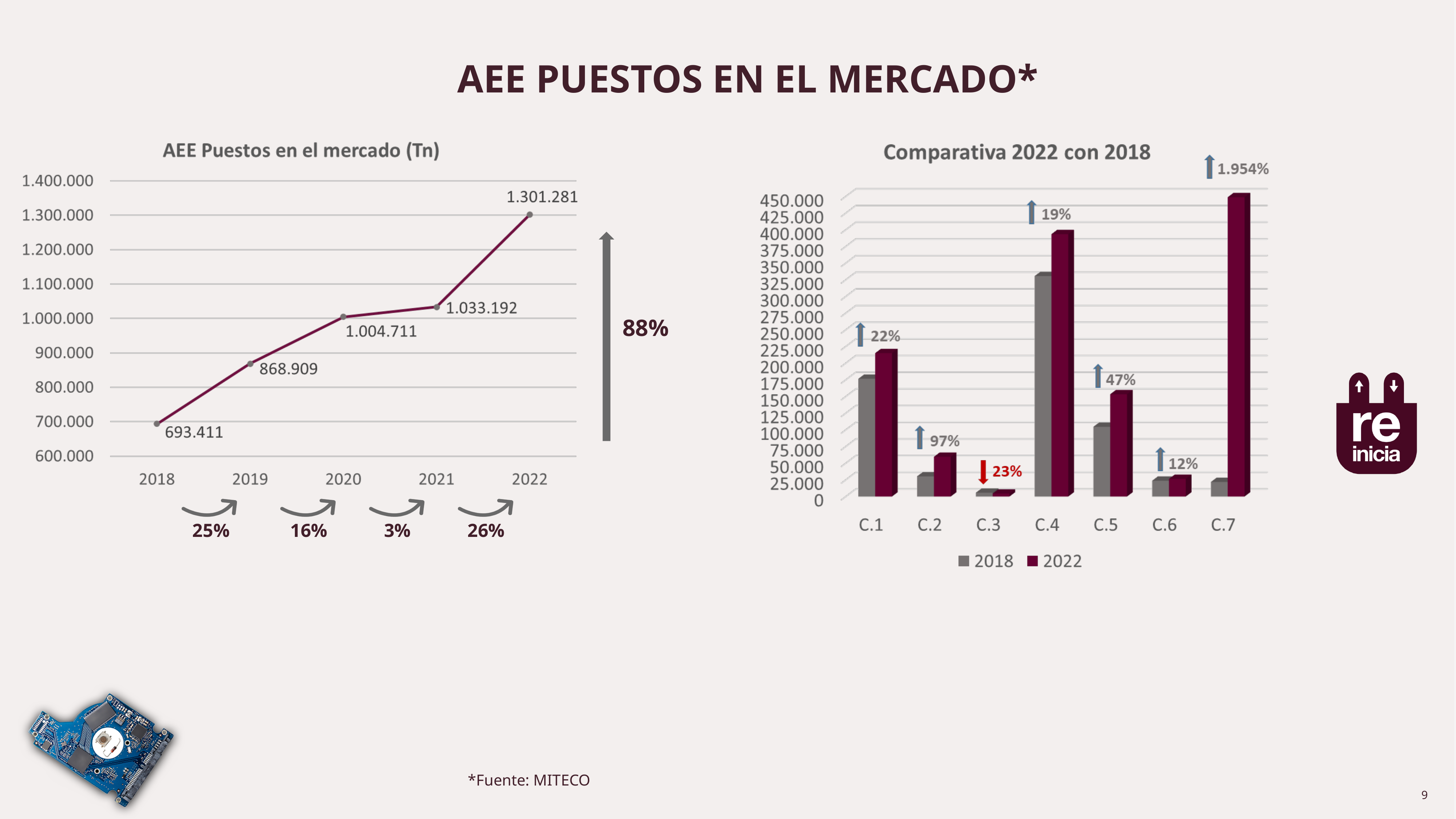
In the chart 'Comparativa 2022 con 2018', is the 2022 value for C.4 greater or less than 375.000? greater In the chart 'AEE Puestos en el mercado (Tn)', how many years are plotted? 5 In the chart 'AEE Puestos en el mercado (Tn)', what is the value for 2022? 1.301.281 In the chart 'Comparativa 2022 con 2018', which category has the highest 2022 value? C.7 In the chart 'AEE Puestos en el mercado (Tn)', which year has the lowest value? 2018 In the chart 'AEE Puestos en el mercado (Tn)', what is the value for 2020? 1.004.711 In the chart 'Comparativa 2022 con 2018', which is larger for C.3, the 2018 value or the 2022 value? 2018 In the chart 'Comparativa 2022 con 2018', how many series does the legend list? 2 In the chart 'AEE Puestos en el mercado (Tn)', do the values rise or fall from 2018 to 2022? rise In the chart 'AEE Puestos en el mercado (Tn)', what is the difference between the 2022 value and the 2018 value? 607.870 In the chart 'AEE Puestos en el mercado (Tn)', what is the value for 2018? 693.411 What kind of chart is 'Comparativa 2022 con 2018'? bar chart